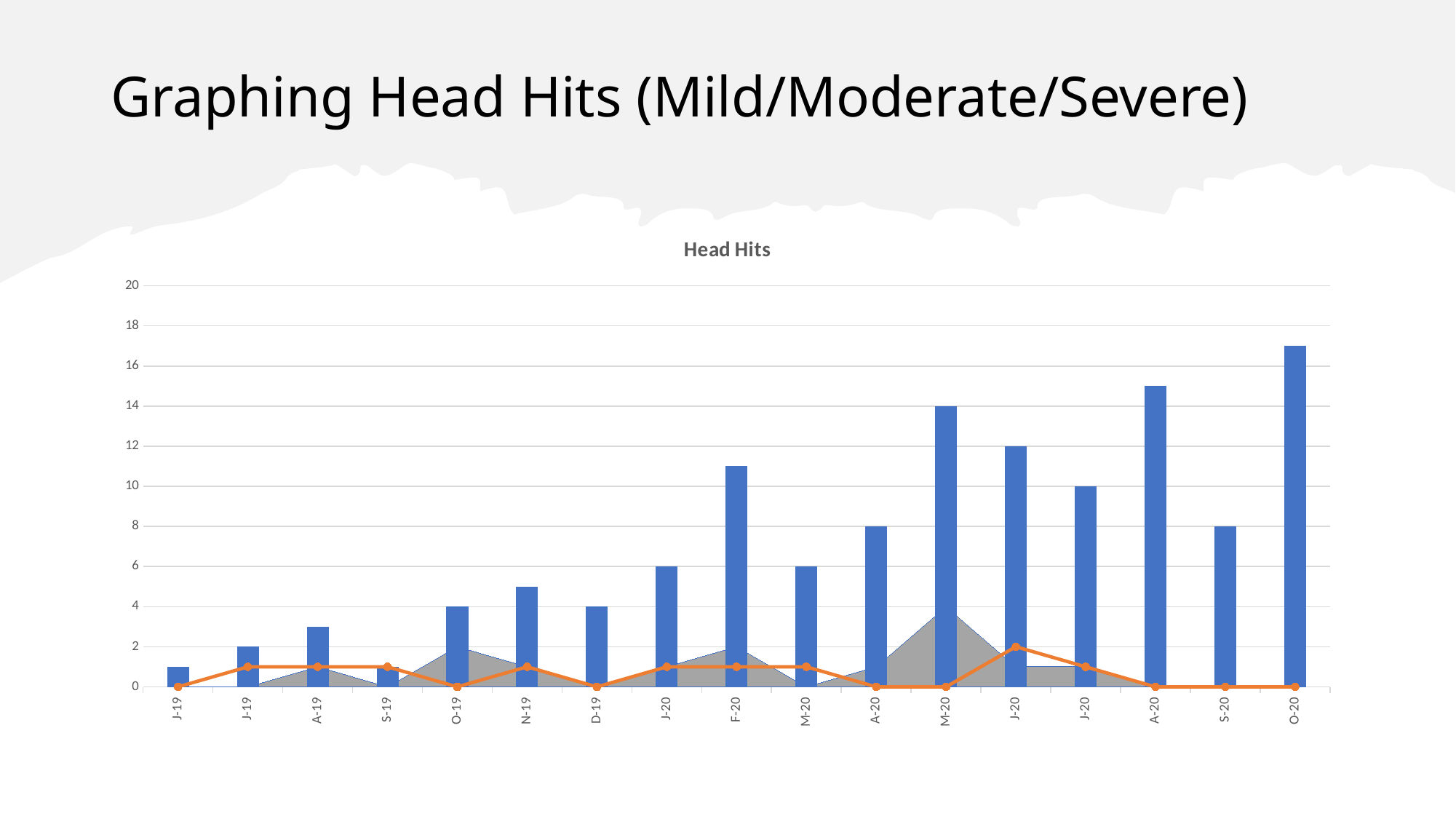
Which has the taller blue bar, F-20 or S-20? F-20 What is the value of the blue bar for O-19? 4 What is the title of the chart? Head Hits What is the value of the blue bar for D-19? 4 What is the value of the blue bar for S-20? 8 What is the difference between the blue bar values for S-20 and O-19? 4 Is the blue bar value for F-20 greater or less than 10? greater How many categories are shown along the x axis of the Head Hits chart? 17 What kind of chart is used for the blue series in the Head Hits chart? bar chart Do the blue bars generally rise or fall from J-19 to O-20? rise Which category has the tallest blue bar in the Head Hits chart? O-20 Is the blue bar value for N-19 greater or less than 6? less